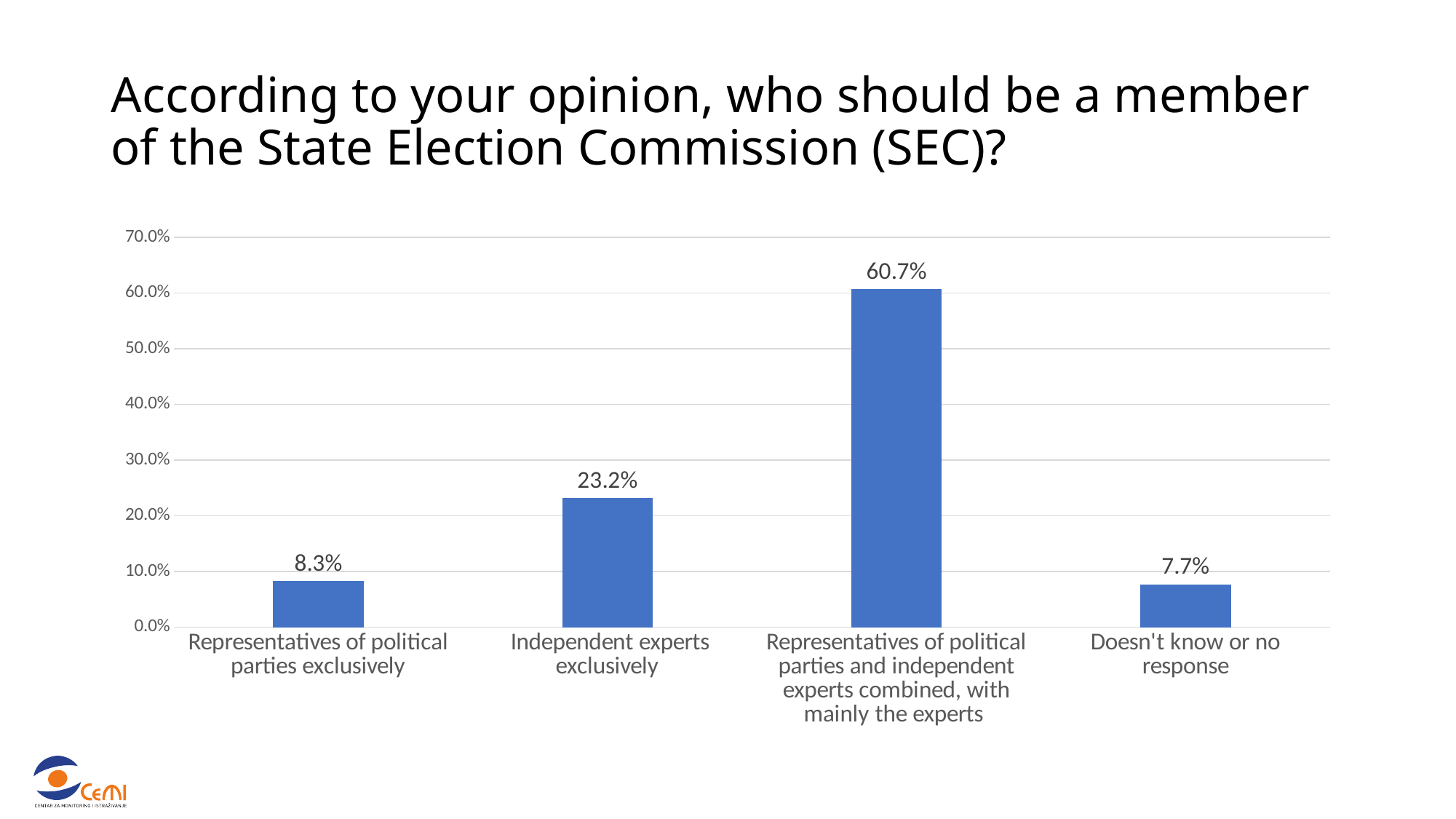
What percentage chose 'Representatives of political parties and independent experts combined, with mainly the experts'? 60.7% Which category has the highest value? Representatives of political parties and independent experts combined, with mainly the experts How many categories are shown on the chart? 4 Is the value for 'Independent experts exclusively' greater or less than 20.0%? greater What percentage of respondents said the SEC should consist of representatives of political parties exclusively? 8.3% What is the title of the slide? According to your opinion, who should be a member of the State Election Commission (SEC)? What kind of chart is shown on the slide? Bar chart What is the difference between the value for 'Representatives of political parties and independent experts combined, with mainly the experts' and the value for 'Independent experts exclusively'? 37.5% What is the value for 'Independent experts exclusively'? 23.2% What is the value for 'Doesn't know or no response'? 7.7% Which is larger: the value for 'Independent experts exclusively' or the value for 'Representatives of political parties exclusively'? Independent experts exclusively Which category has the lowest value? Doesn't know or no response